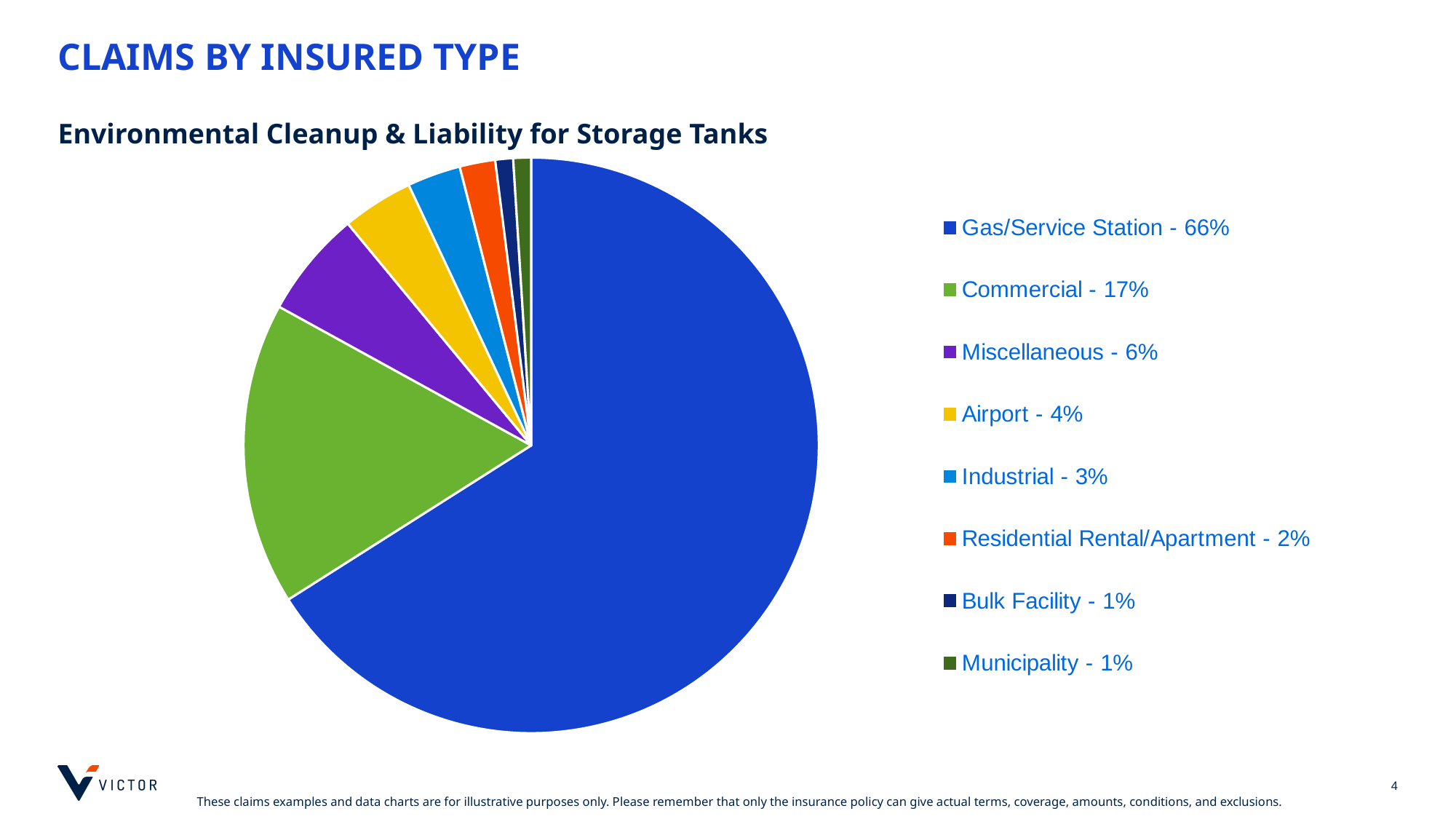
Which has a larger share, Airport or Industrial? Airport Which insured type has the largest share of claims? Gas/Service Station What share of claims is attributed to Commercial? 17% What percentage is shown for Miscellaneous? 6% What is the difference in percentage points between Gas/Service Station and Commercial? 49 How many insured types are listed in the legend? 8 Which two insured types each account for 1% of claims? Bulk Facility and Municipality What is the difference in percentage points between Miscellaneous and Airport? 2 What share of claims is attributed to Gas/Service Station? 66% What percentage is shown for Residential Rental/Apartment? 2% What kind of chart is shown on the slide? Pie chart What is the subtitle shown above the pie chart? Environmental Cleanup & Liability for Storage Tanks